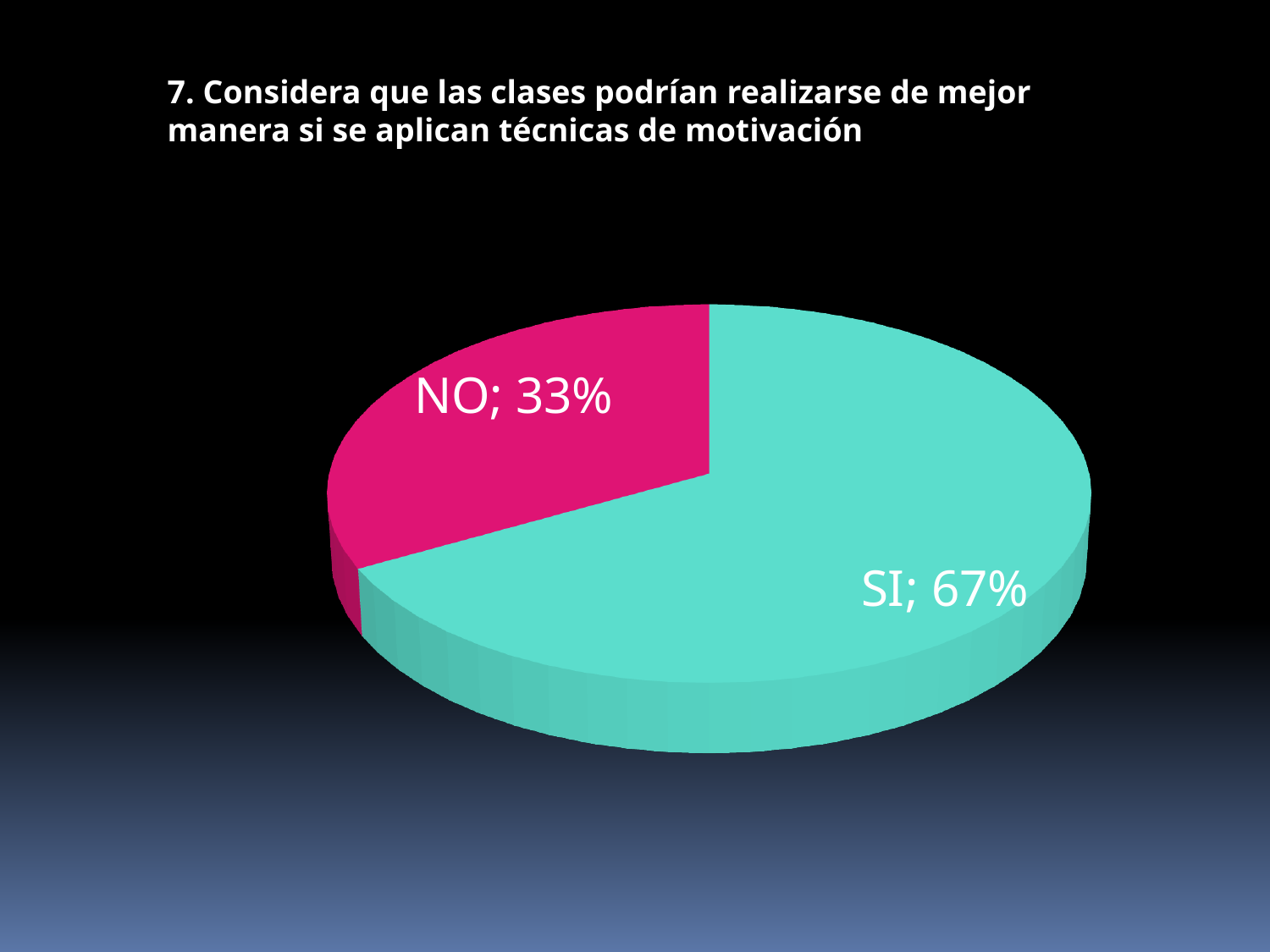
What percentage of the pie is labelled SI? 67% What share of the pie does the SI slice represent? 67% What is the difference in percentage points between the SI and NO slices? 34 What colour is the NO slice of the pie? Pink What percentage of the pie is labelled NO? 33% Which is larger, the SI slice or the NO slice? SI What kind of chart is shown on the slide? Pie chart What colour is the SI slice of the pie? Turquoise Which slice of the pie is the smallest? NO How many slices does the pie chart have? 2 Which slice of the pie is the largest? SI